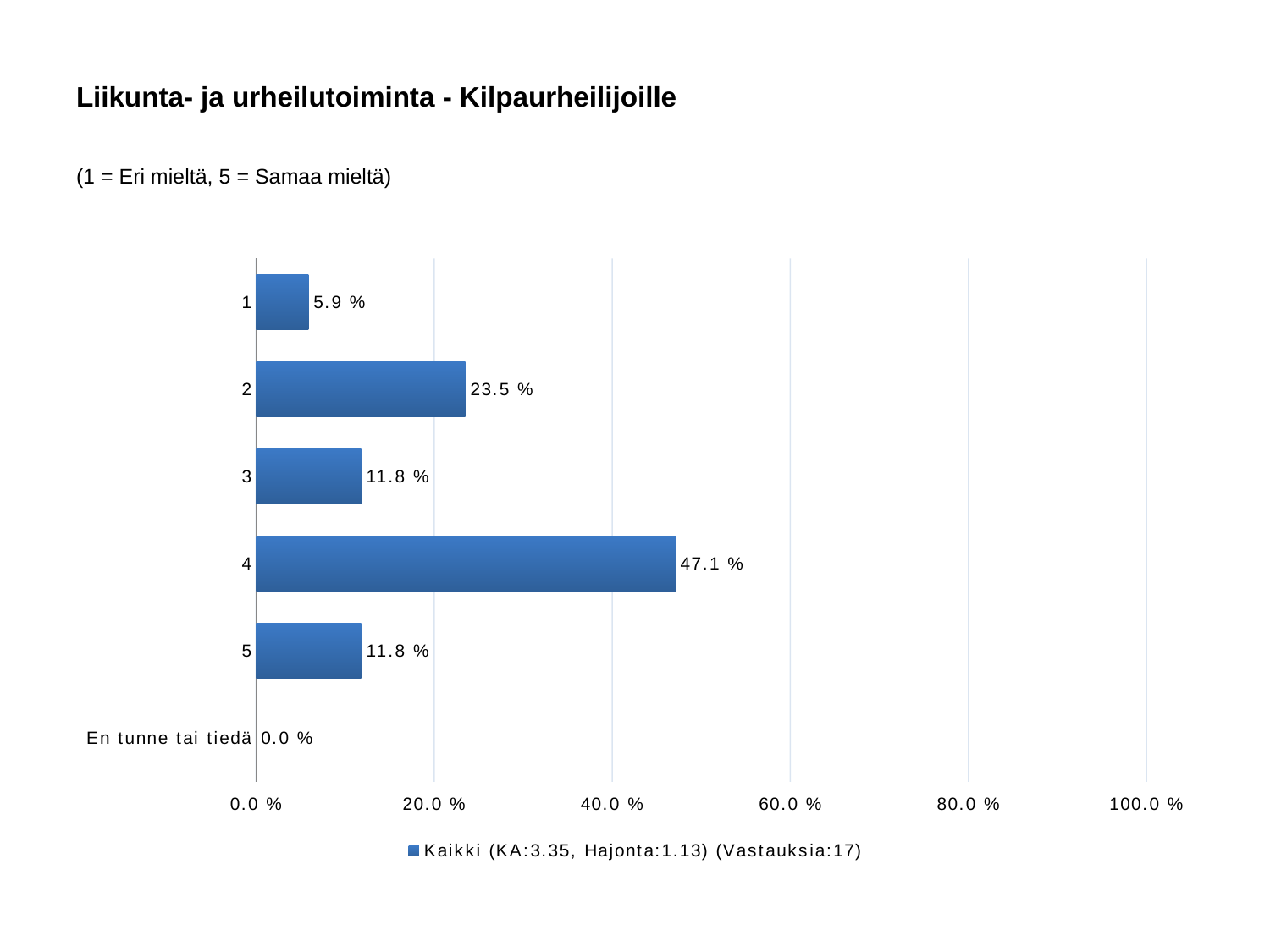
What is the value for category 4? 47.1 % Is the value for category 4 greater or less than 40.0 %? greater What is the value for 'En tunne tai tiedä'? 0.0 % What is the legend entry of the chart? Kaikki (KA:3.35, Hajonta:1.13) (Vastauksia:17) What kind of chart is shown on the slide? bar chart What is the value for category 1? 5.9 % Which is larger, the value for category 2 or the value for category 3? 2 What is the difference between the values for category 4 and category 2? 23.6 % How many categories are shown on the chart? 6 What is the value for category 2? 23.5 % Which category has the lowest value? En tunne tai tiedä Which category has the highest value? 4